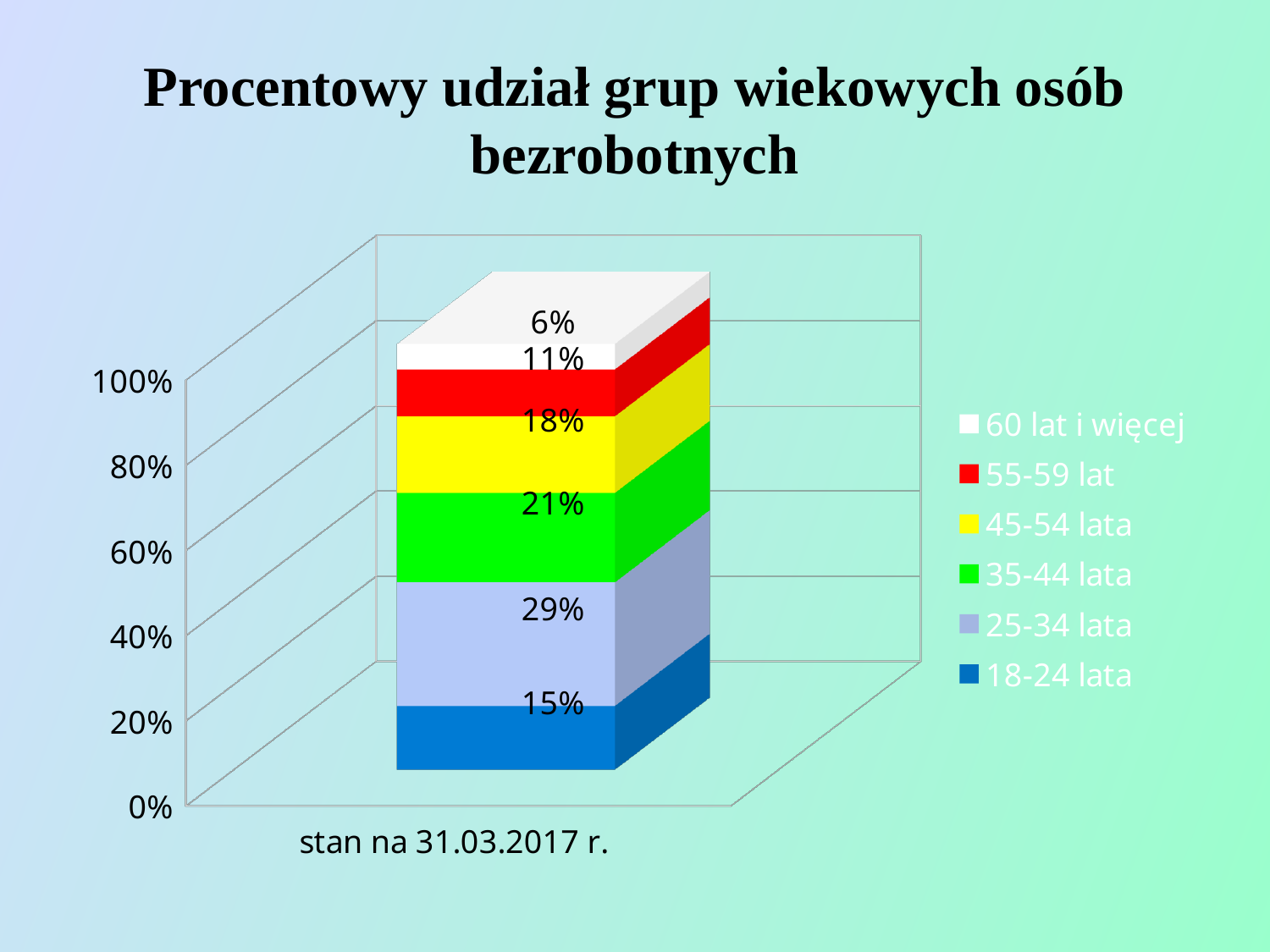
What percentage share does the 25-34 lata age group have? 29% What is the difference between the shares of the 25-34 lata and 35-44 lata groups? 8% What kind of chart is shown on the slide? Stacked bar chart How many series does the legend list? 6 What is the category label shown under the bar? stan na 31.03.2017 r. What share is shown for the 60 lat i więcej group? 6% What is the value shown for the 18-24 lata series? 15% What is the value for the 45-54 lata segment? 18% Which age group has the smallest share? 60 lat i więcej Which age group has the largest share of the unemployed? 25-34 lata Which is larger, the share for 55-59 lat or the share for 18-24 lata? 18-24 lata What is the total of all segments in the stacked bar? 100%